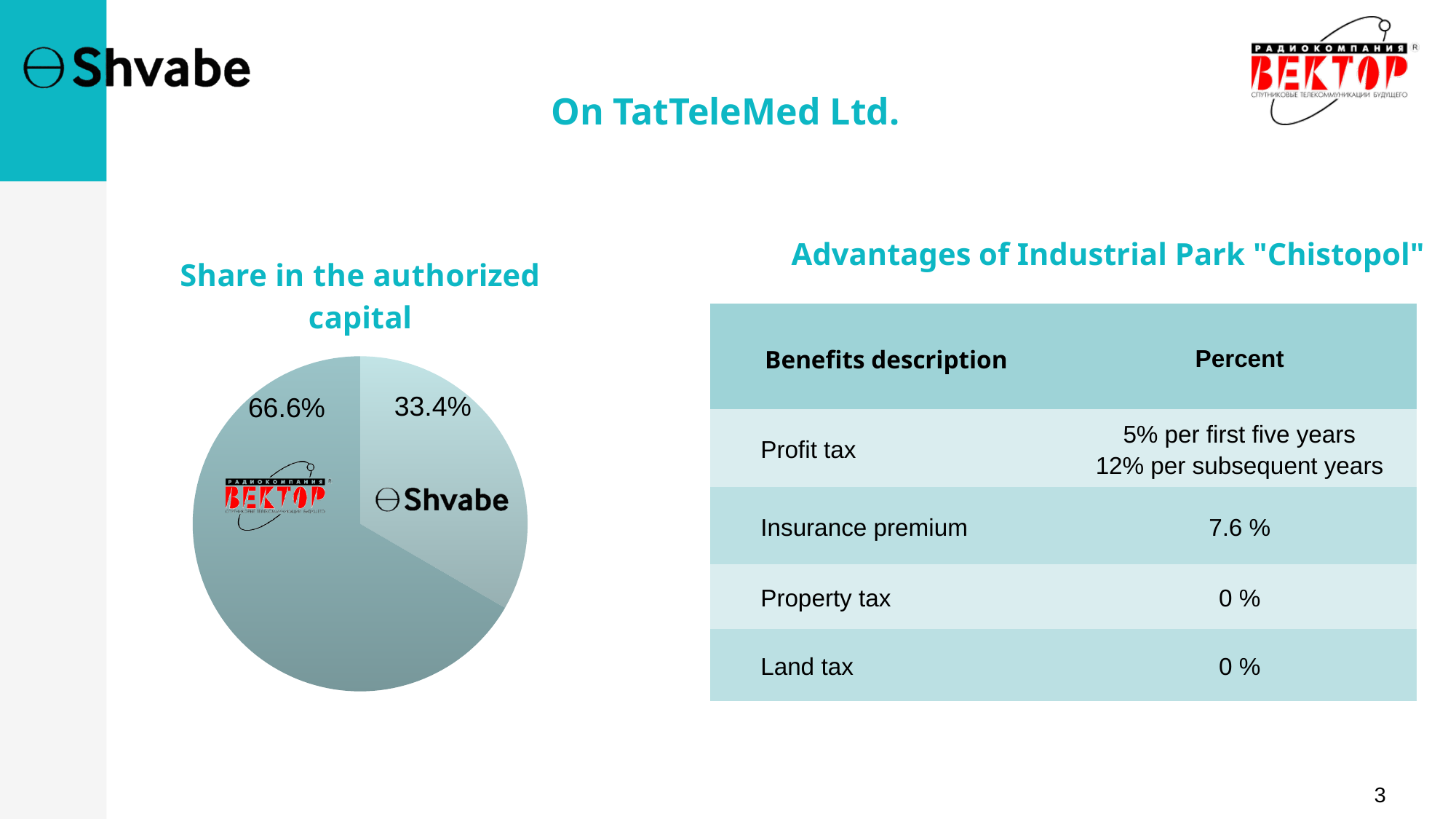
In the "Share in the authorized capital" pie chart, what share is labelled for the Vektor (ВЕКТОР) slice? 66.6% What is the title of the pie chart on the slide? Share in the authorized capital In the "Share in the authorized capital" pie chart, what share is labelled for the Shvabe slice? 33.4% In the "Share in the authorized capital" pie chart, what is the difference between the Vektor share and the Shvabe share? 33.2% In the "Share in the authorized capital" pie chart, which slice is the largest? Vektor (ВЕКТОР) In the "Share in the authorized capital" pie chart, is the Vektor share greater or less than 50%? greater In the "Share in the authorized capital" pie chart, is the Shvabe share greater or less than 50%? less What kind of chart is shown under the title "Share in the authorized capital"? pie chart In the "Share in the authorized capital" pie chart, which is larger: the Shvabe share or the Vektor share? Vektor How many slices does the "Share in the authorized capital" pie chart have? 2 In the "Share in the authorized capital" pie chart, which slice is the smallest? Shvabe In the pie chart, how are the two slices identified? By company logos (Shvabe and ВЕКТОР)